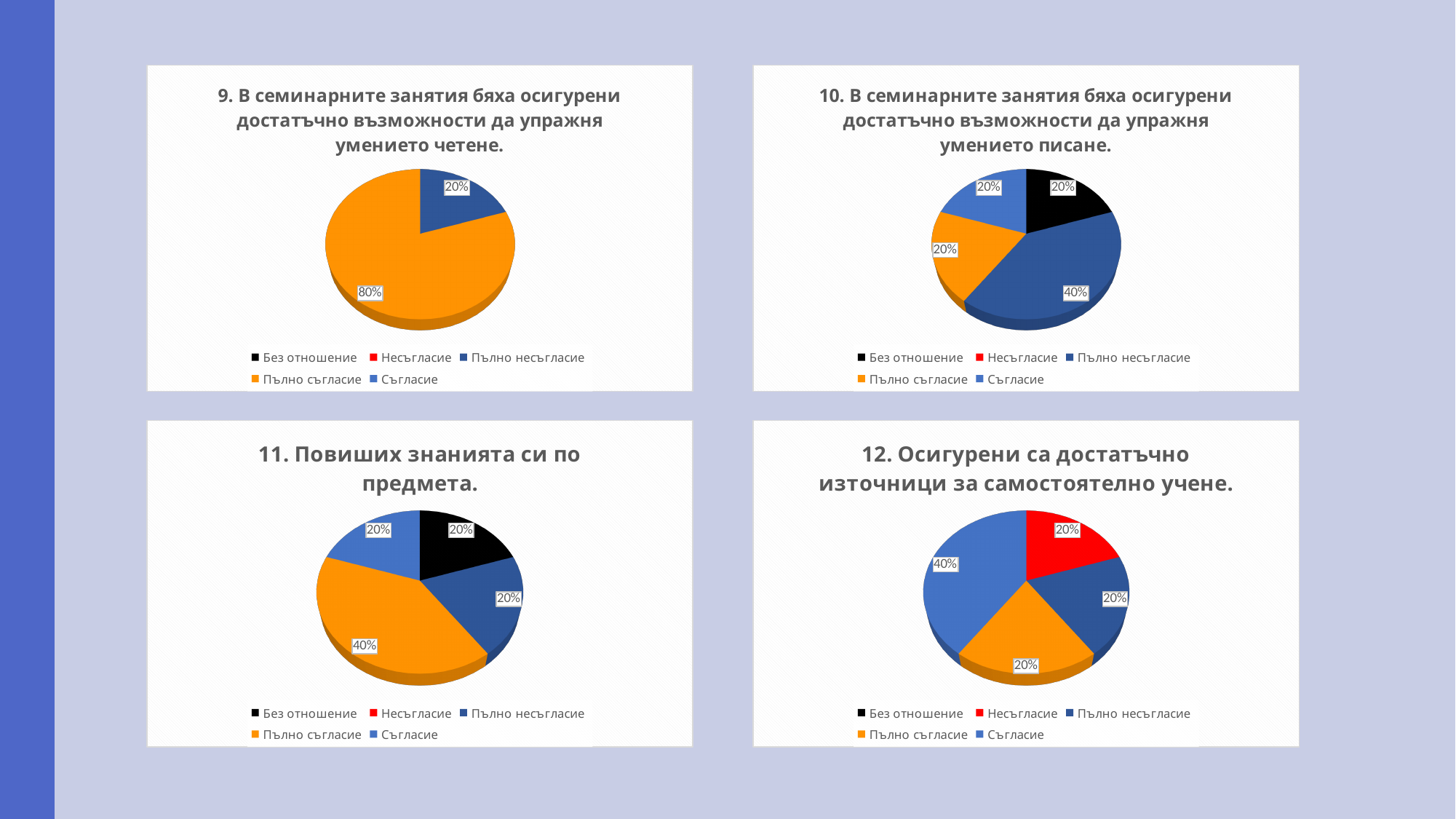
In chart 10 (top-right), what share of the pie is Пълно несъгласие? 40% In chart 11 (bottom-left), which is larger, the Пълно съгласие slice or the Без отношение slice? Пълно съгласие How many entries does the legend of chart 12 (bottom-right) list? 5 In chart 12 (bottom-right), what share of the pie is Несъгласие? 20% In chart 9 (top-left), what share of the pie is Пълно съгласие? 80% What kind of chart is chart 11 (bottom-left)? Pie chart In chart 9 (top-left), which category has the largest slice? Пълно съгласие In chart 10 (top-right), what is the difference between the Пълно несъгласие slice and the Съгласие slice? 20% In chart 10 (top-right), which category has the largest slice? Пълно несъгласие